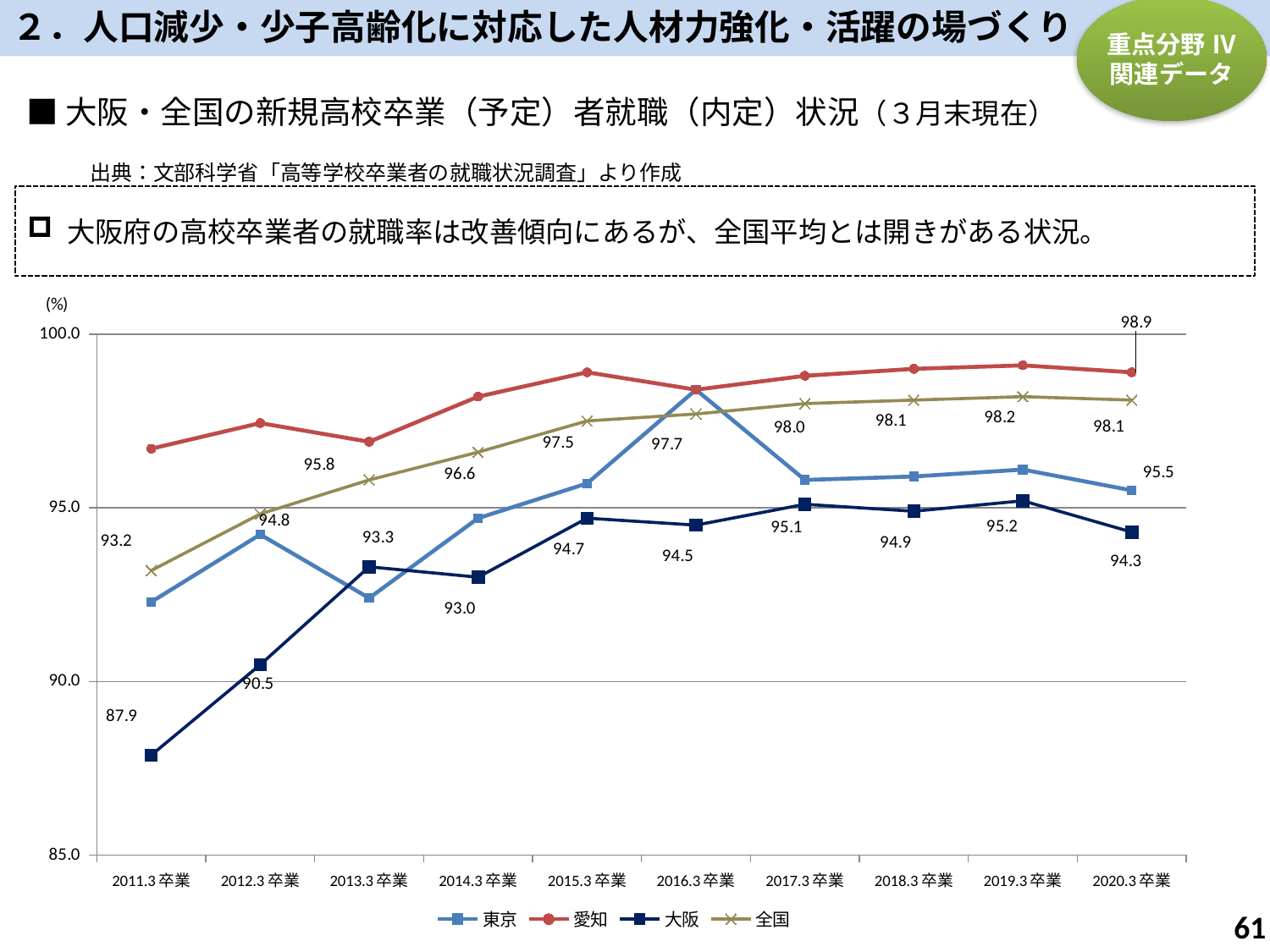
Is the value for 愛知 at 2011.3卒業 greater or less than 95.0? greater Which series is plotted with the red line? 愛知 What is the value for 全国 at 2014.3卒業? 96.6 How many series does the legend list? 4 In which graduation year is the 大阪 value lowest? 2011.3卒業 What is the value for 大阪 at 2020.3卒業? 94.3 What is the value for 大阪 at 2011.3卒業? 87.9 In which graduation year is the 大阪 value highest? 2019.3卒業 How many graduation years are plotted along the x axis? 10 What is the difference between the 全国 and 大阪 values at 2020.3卒業? 3.8 What type of chart is shown on the slide? line chart What is the value for 全国 at 2019.3卒業? 98.2